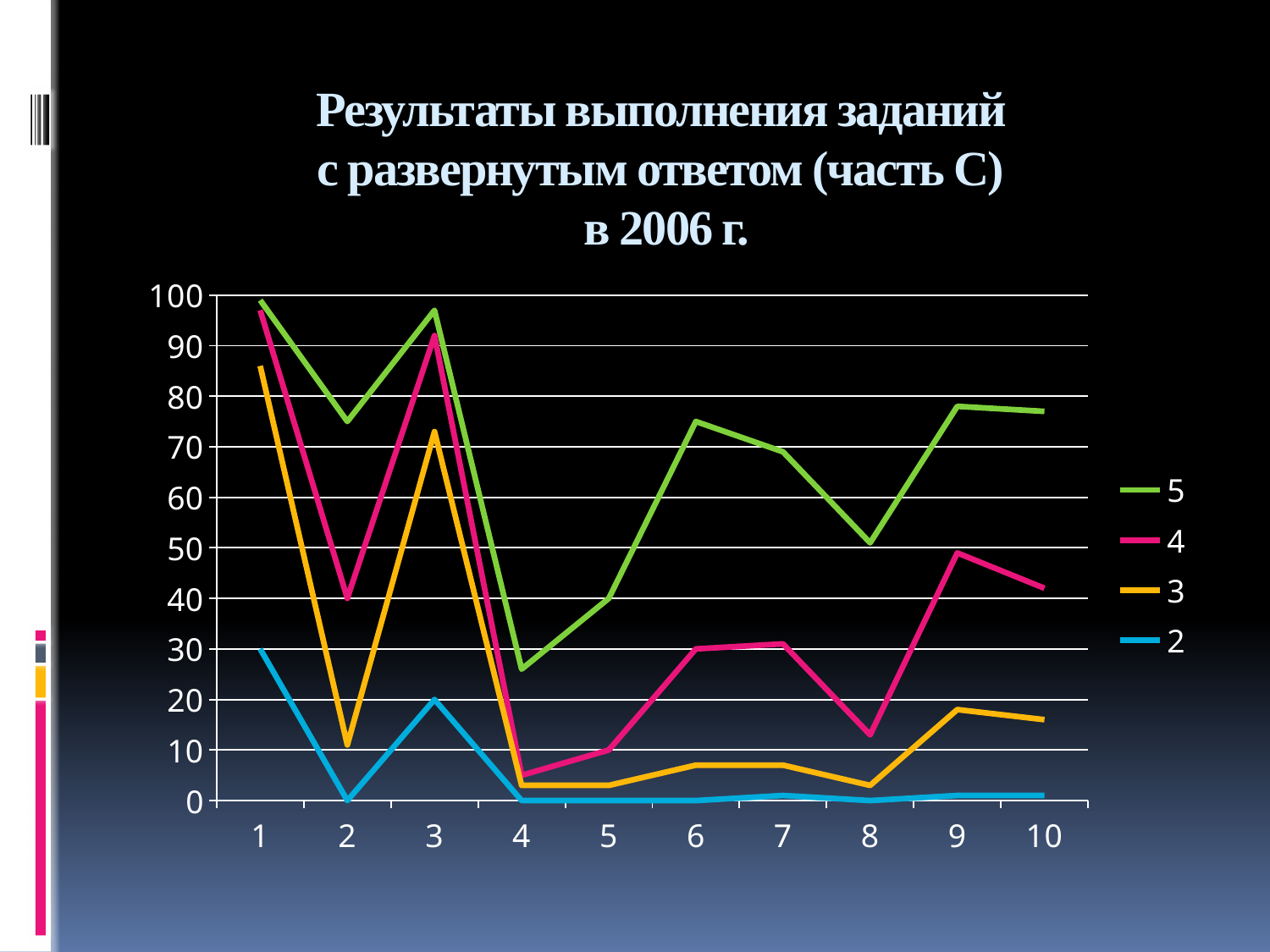
What kind of chart is shown on the slide? line chart How many series does the legend list? 4 Does series 5 rise or fall from x = 8 to x = 9? rise Is the value of series 3 at x = 1 greater or less than 80? greater Is the value of series 5 at x = 6 greater or less than 70? greater What colour is the line for series 2 in the legend? blue How many points are there along the x axis? 10 Which is larger at x = 3: the value of series 4 or the value of series 3? series 4 Which series has the highest value at x = 1? 5 Is the value of series 4 at x = 4 greater or less than 10? less Which series has the lowest value at x = 9? 2